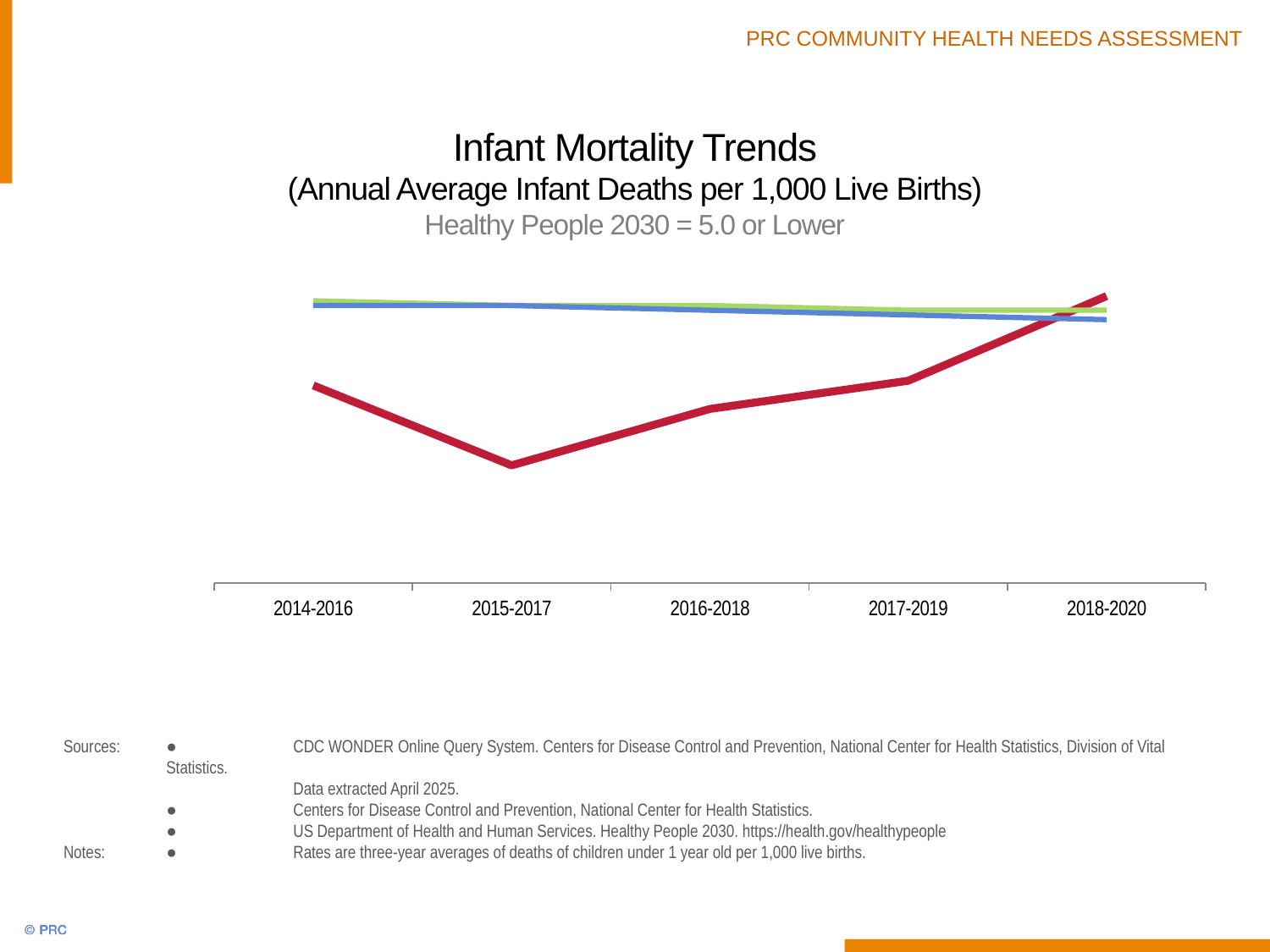
What Healthy People 2030 target is stated on the slide? 5.0 or Lower What is the first time period shown on the x axis? 2014-2016 How many time periods are shown on the x axis? 5 Does the red line rise or fall between 2015-2017 and 2018-2020? Rise What is the title of the chart? Infant Mortality Trends (Annual Average Infant Deaths per 1,000 Live Births) In which period does the red line reach its lowest point? 2015-2017 At 2018-2020, which is higher, the red line or the blue line? Red line At 2014-2016, which is higher, the red line or the blue line? Blue line What kind of chart is shown on the slide? Line chart In which period does the red line reach its highest point? 2018-2020 How many lines are plotted on the chart? 3 Does the red line rise or fall between 2014-2016 and 2015-2017? Fall